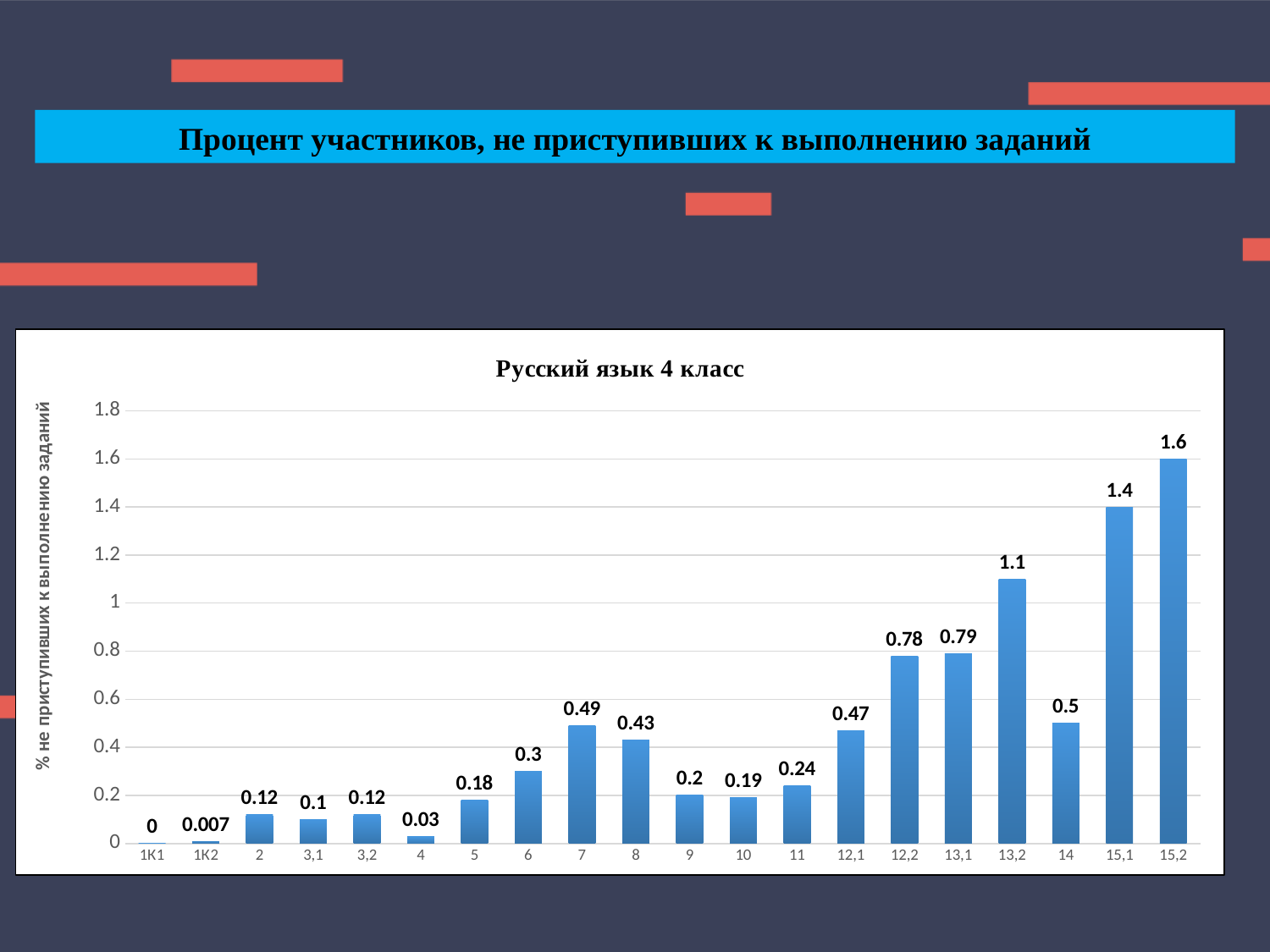
What is the title of the chart? Русский язык 4 класс What is the value for task 15,2 in the chart? 1.6 What is the difference between the values for tasks 15,2 and 15,1? 0.2 What is the value for task 1К2 in the chart? 0.007 Is the value for task 13,2 greater or less than 1? greater Which task has the highest percentage of participants who did not start it? 15,2 What kind of chart is shown on the slide? bar chart What is the value for task 7 in the chart? 0.49 What is the value for task 12,2 in the chart? 0.78 How many tasks (categories) are shown on the x axis of the chart? 20 Which has a larger value, task 7 or task 8? 7 Which task has the lowest value in the chart? 1К1